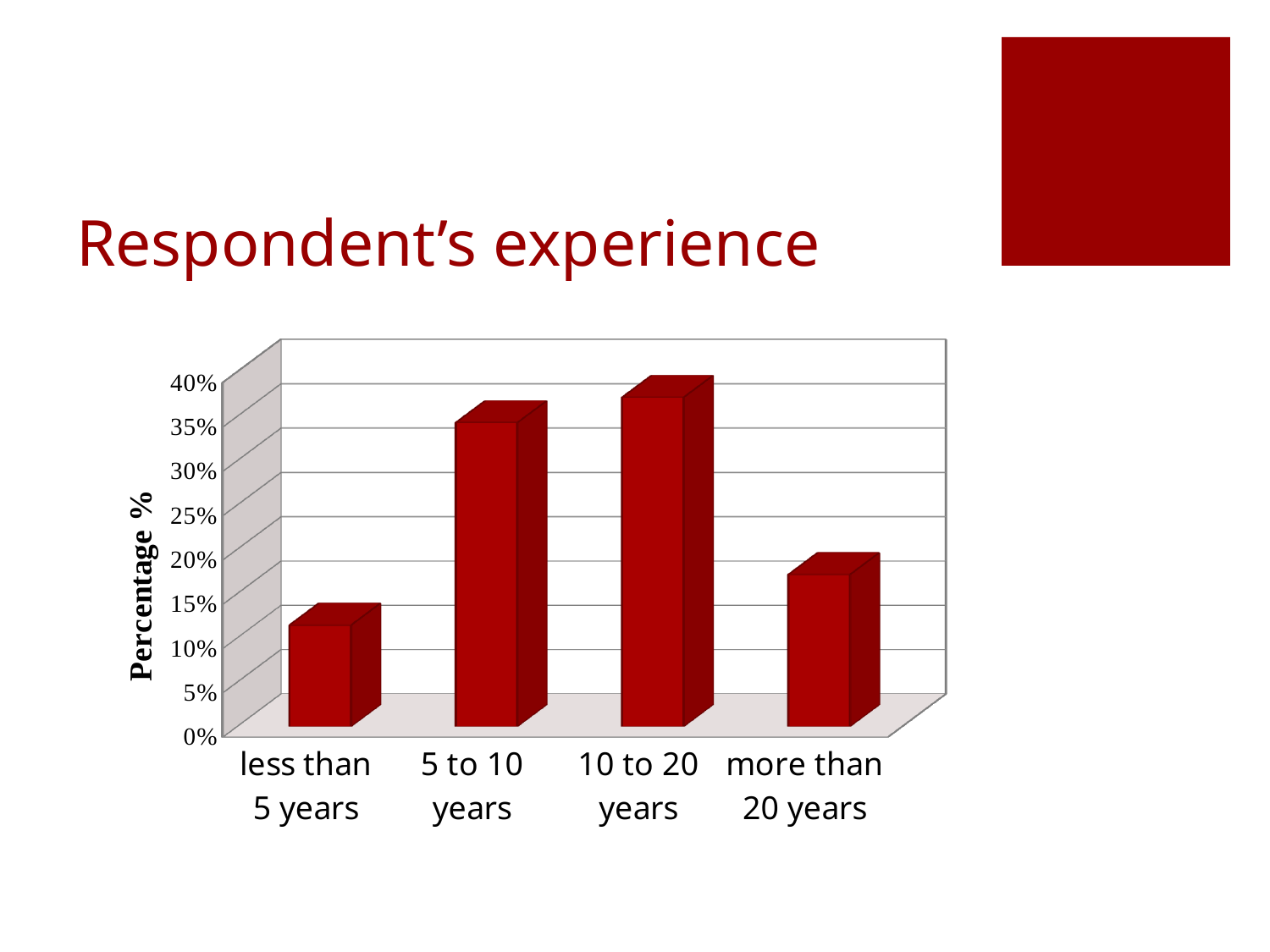
Is the value for 'less than 5 years' greater or less than 20%? less What kind of chart is shown on the slide? bar chart Which experience category has the lowest percentage? less than 5 years Is the value for '10 to 20 years' greater or less than 35%? greater Which experience category has the highest percentage? 10 to 20 years Is the value for 'more than 20 years' greater or less than 25%? less What is the label on the vertical axis? Percentage % Which is larger, the value for 'more than 20 years' or for 'less than 5 years'? more than 20 years How many experience categories are shown on the x axis? 4 Which is larger, the value for '5 to 10 years' or for 'less than 5 years'? 5 to 10 years What is the title of the slide containing the chart? Respondent's experience